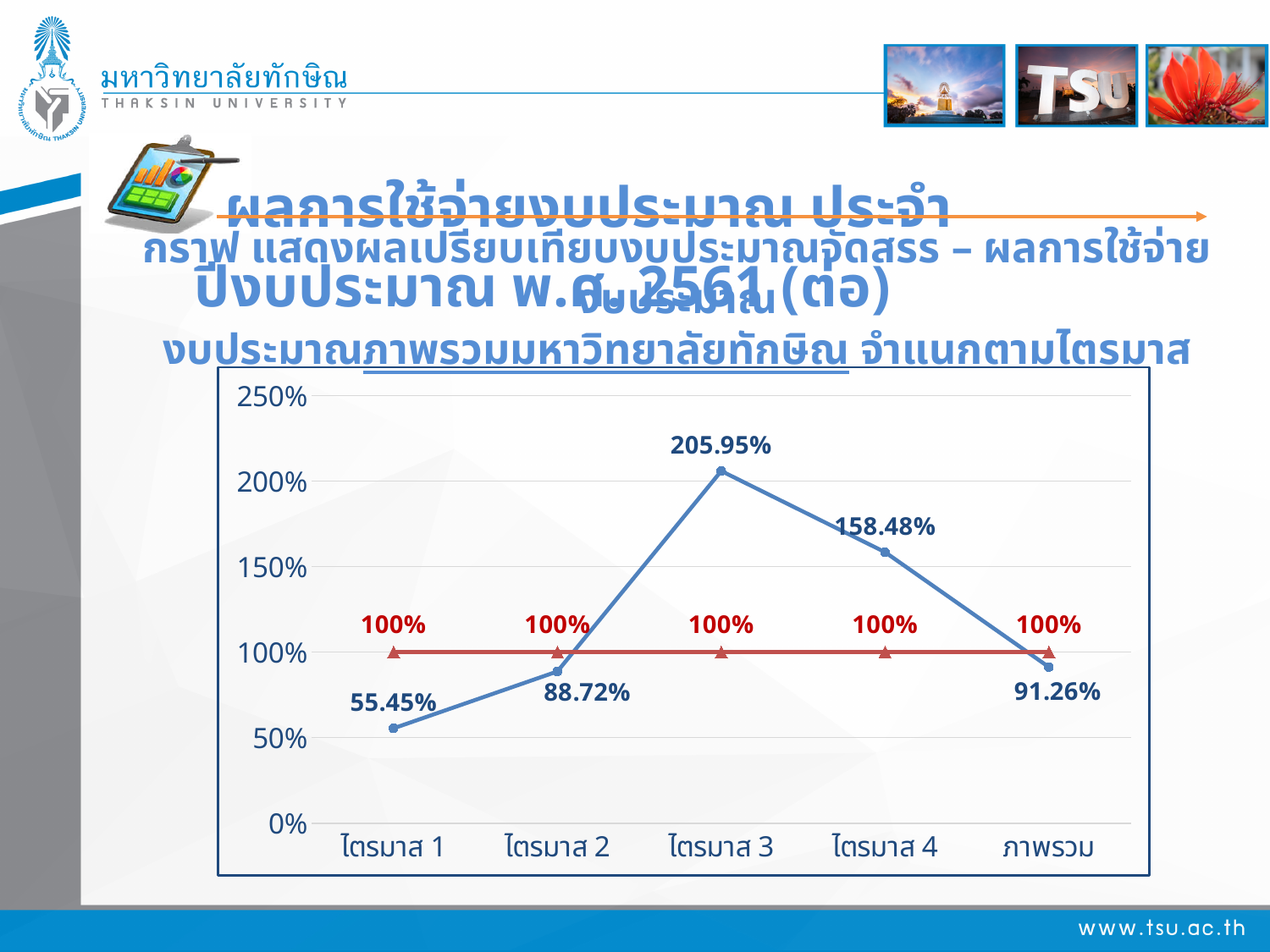
Which category has the highest value on the blue line? ไตรมาส 3 Which category has the lowest value on the blue line? ไตรมาส 1 What is the value of the blue line for ภาพรวม? 91.26% What is the value of the red line for ไตรมาส 4? 100% Does the blue line rise or fall from ไตรมาส 1 to ไตรมาส 3? rise What is the value of the blue line for ไตรมาส 3? 205.95% How many categories are shown on the x axis? 5 What kind of chart is shown on the slide? line chart Which is larger on the blue line: ไตรมาส 2 or ภาพรวม? ภาพรวม What is the difference between the blue line values for ไตรมาส 3 and ไตรมาส 4? 47.47% Is the blue line value for ไตรมาส 4 greater or less than 150%? greater What is the value of the blue line for ไตรมาส 1? 55.45%